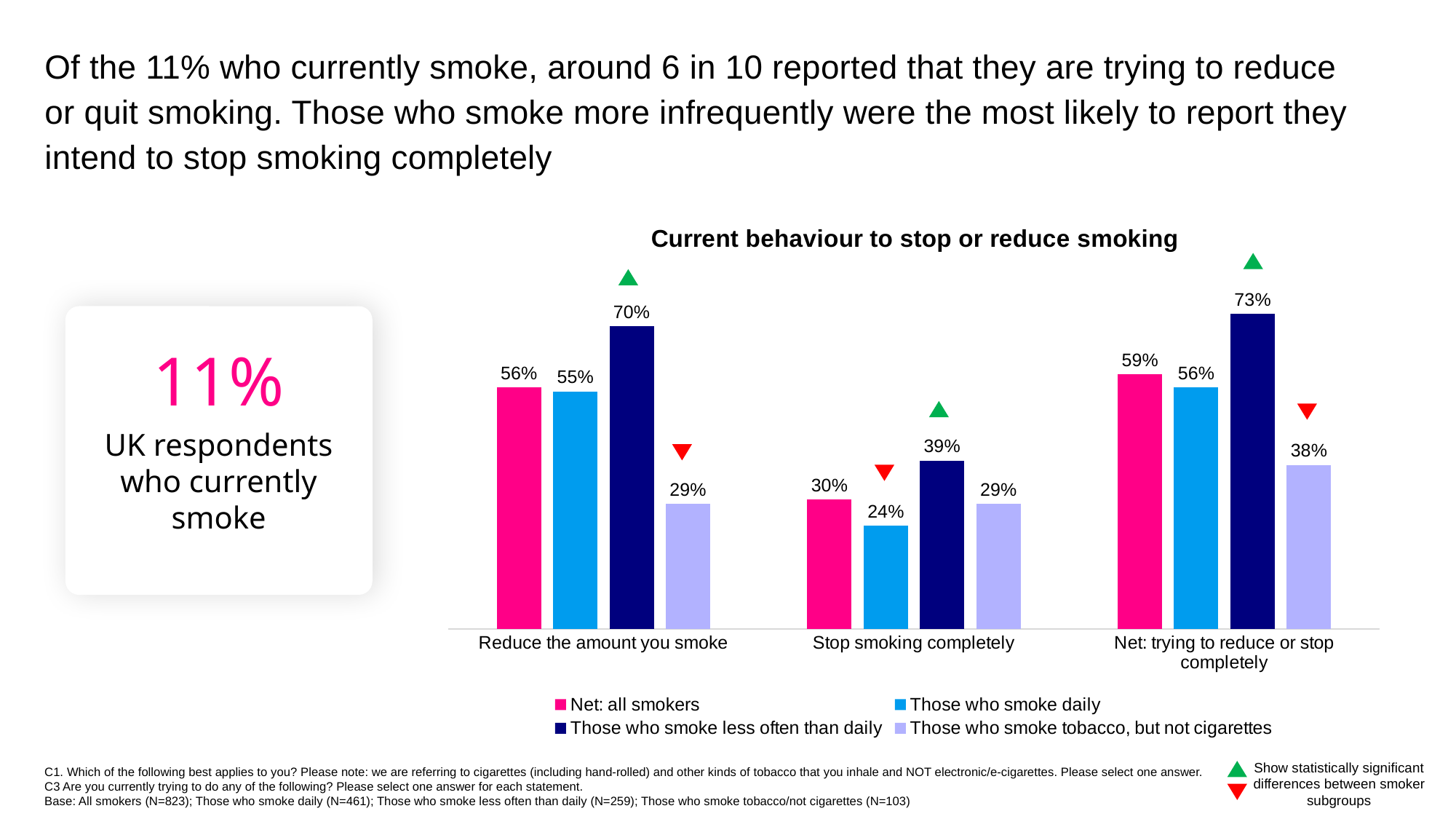
What is the value for 'Those who smoke tobacco, but not cigarettes' in the 'Net: trying to reduce or stop completely' category? 38% What is the difference between 'Net: all smokers' and 'Those who smoke daily' in the 'Net: trying to reduce or stop completely' category? 3 percentage points How many categories are shown on the x axis of the chart? 3 What is the value for 'Those who smoke less often than daily' in the 'Reduce the amount you smoke' category? 70% What is the difference between 'Those who smoke less often than daily' and 'Those who smoke tobacco, but not cigarettes' in the 'Reduce the amount you smoke' category? 41 percentage points Which series has the highest value in the 'Net: trying to reduce or stop completely' category? Those who smoke less often than daily How many series does the legend list? 4 Which series has the lowest value in the 'Stop smoking completely' category? Those who smoke daily What is the title of the chart? Current behaviour to stop or reduce smoking What kind of chart is shown on the slide? Bar chart In the 'Stop smoking completely' category, which is larger: 'Those who smoke less often than daily' or 'Those who smoke tobacco, but not cigarettes'? Those who smoke less often than daily What is the value for 'Net: all smokers' in the 'Stop smoking completely' category? 30%